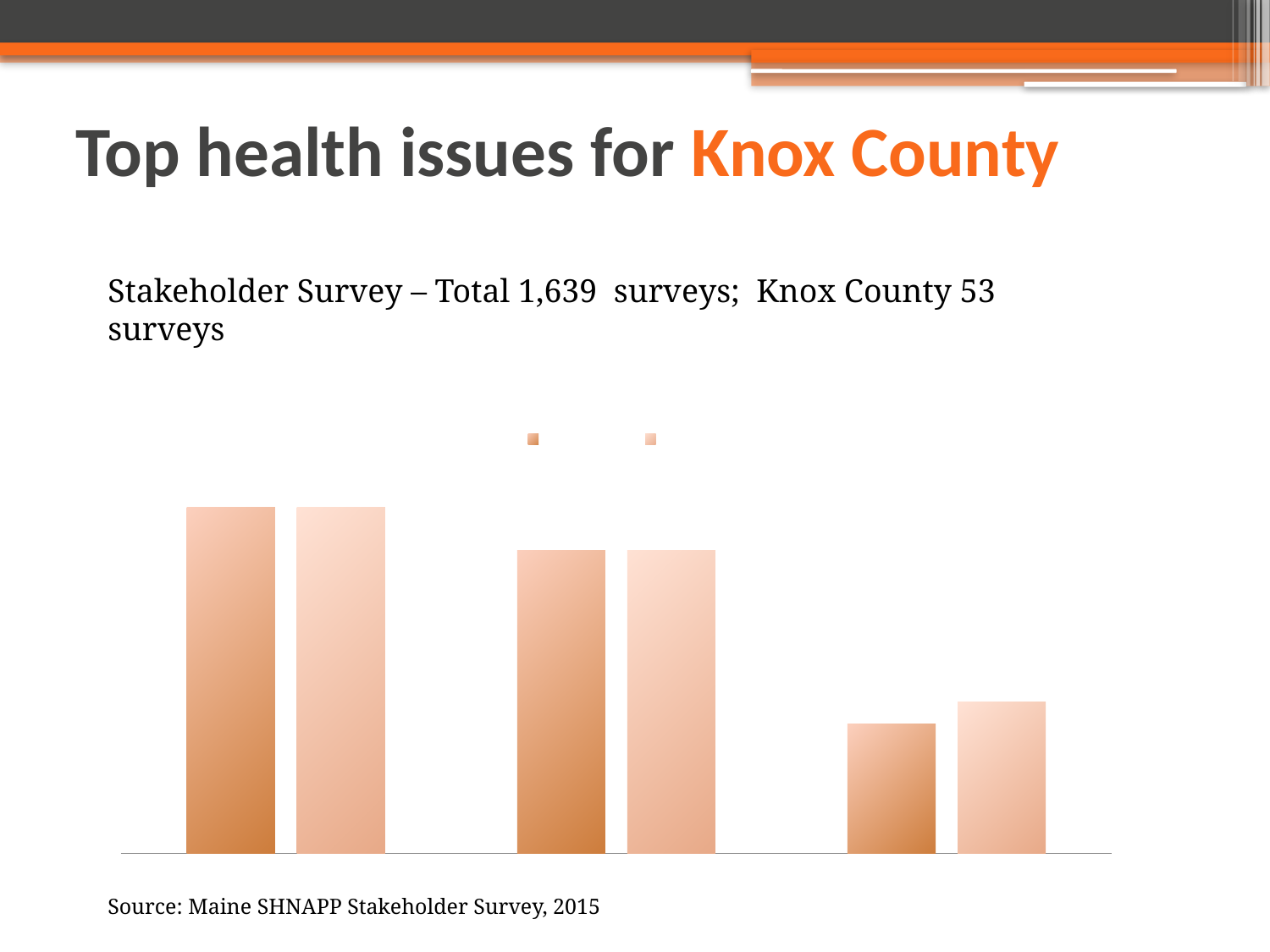
In the rightmost group, which bar is taller: the darker orange bar or the lighter orange bar? the lighter orange bar How many series does the chart's legend list? 2 How many bars are plotted in total on the chart? 6 Do the bar heights rise or fall from left to right across the groups? fall How many groups of bars does the chart show? 3 Which group of bars is the shortest: the left, middle, or right group? right What kind of chart is shown on the slide? bar chart Which group of bars is the tallest: the left, middle, or right group? left What source is cited below the chart? Maine SHNAPP Stakeholder Survey, 2015 What is the title of the slide containing the chart? Top health issues for Knox County